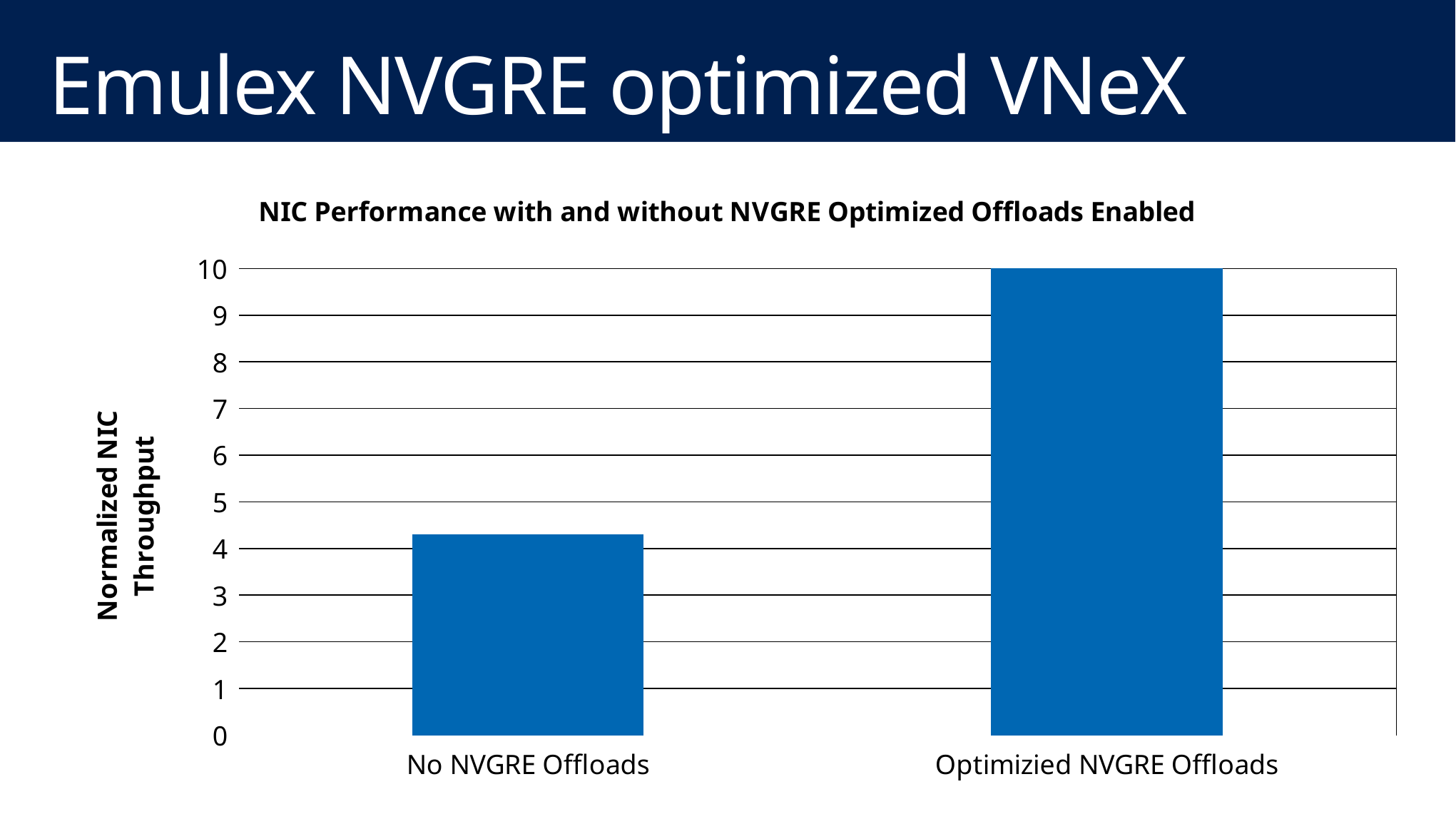
What is the label of the vertical axis? Normalized NIC Throughput Is the value for No NVGRE Offloads greater or less than 5? less How many categories are shown on the x axis? 2 Is the value for Optimizied NVGRE Offloads greater or less than 9? greater What is the title of the chart? NIC Performance with and without NVGRE Optimized Offloads Enabled What kind of chart is shown on the slide? Bar chart Is the value for No NVGRE Offloads greater or less than 4? greater What is the maximum value shown on the vertical axis? 10 Which category has the lowest normalized NIC throughput? No NVGRE Offloads What is the normalized NIC throughput for Optimizied NVGRE Offloads? 10 Which category has the highest normalized NIC throughput? Optimizied NVGRE Offloads Which is larger, the value for No NVGRE Offloads or the value for Optimizied NVGRE Offloads? Optimizied NVGRE Offloads